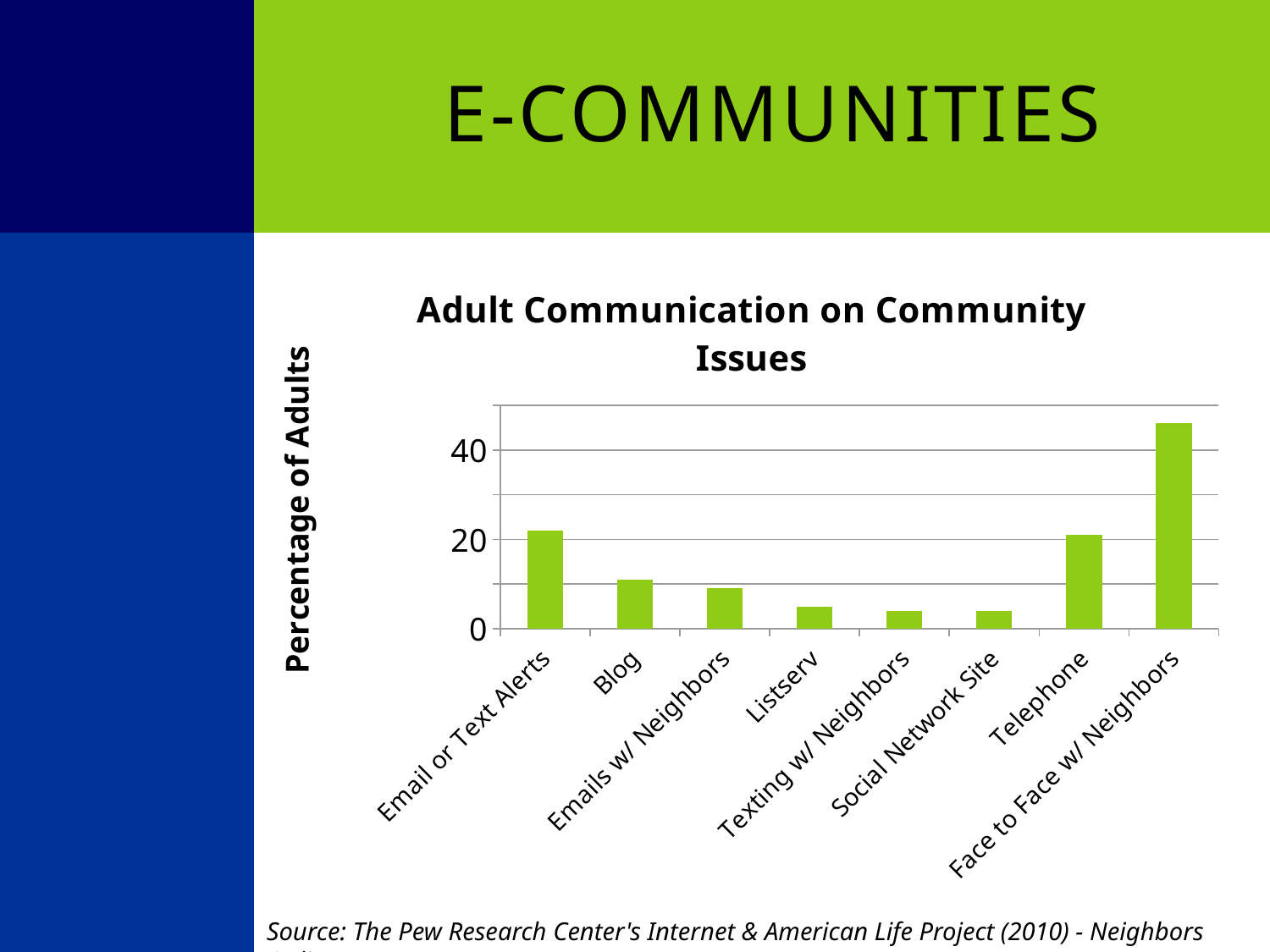
Is the value for Listserv greater or less than 20? less Which is larger, the value for Face to Face w/ Neighbors or the value for Telephone? Face to Face w/ Neighbors Which category has the highest value? Face to Face w/ Neighbors What kind of chart is shown on the slide? bar chart What is the title of the chart? Adult Communication on Community Issues What is the label on the vertical axis of the chart? Percentage of Adults Which is larger, the value for Email or Text Alerts or the value for Emails w/ Neighbors? Email or Text Alerts Which is larger, the value for Blog or the value for Listserv? Blog Is the value for Social Network Site greater or less than 20? less Is the value for Face to Face w/ Neighbors greater or less than 40? greater How many categories are plotted on the chart? 8